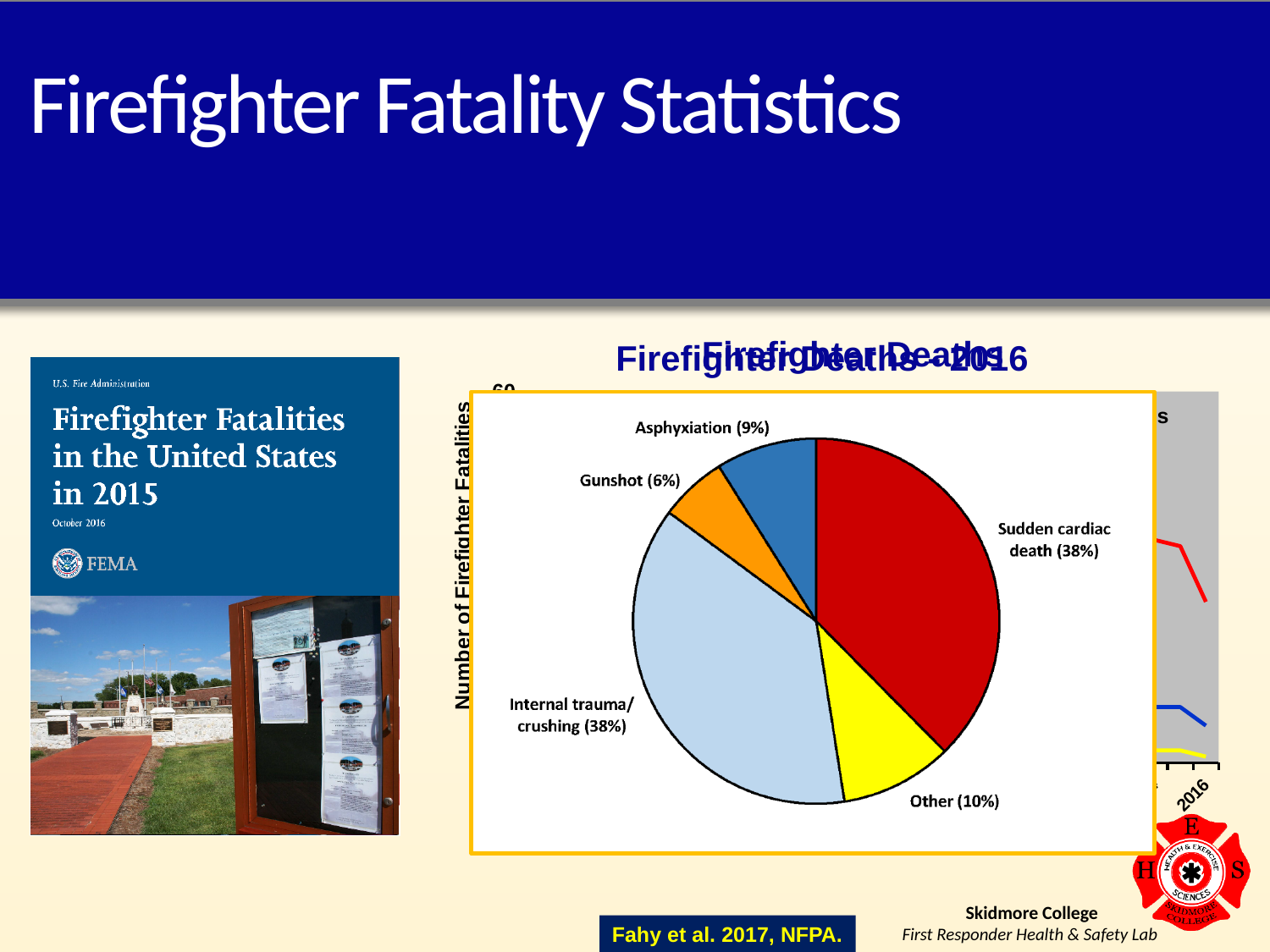
In the pie chart, what is the difference in percentage points between Sudden cardiac death and Asphyxiation? 29 In the pie chart, what percentage is labelled for Other? 10% In the pie chart, what colour is the Sudden cardiac death slice? Red In the pie chart, what share of firefighter deaths is attributed to sudden cardiac death? 38% In the pie chart, what percentage is labelled for Asphyxiation? 9% How many slices does the pie chart have? 5 In the pie chart, what share is labelled for Internal trauma/crushing? 38% In the pie chart, which category has the smallest slice? Gunshot In the pie chart, which is larger: the Asphyxiation slice or the Gunshot slice? Asphyxiation In the pie chart, what percentage is labelled for Gunshot? 6% In the pie chart, what is the difference in percentage points between Other and Gunshot? 4 What kind of chart is the chart with the Sudden cardiac death and Gunshot labels? Pie chart